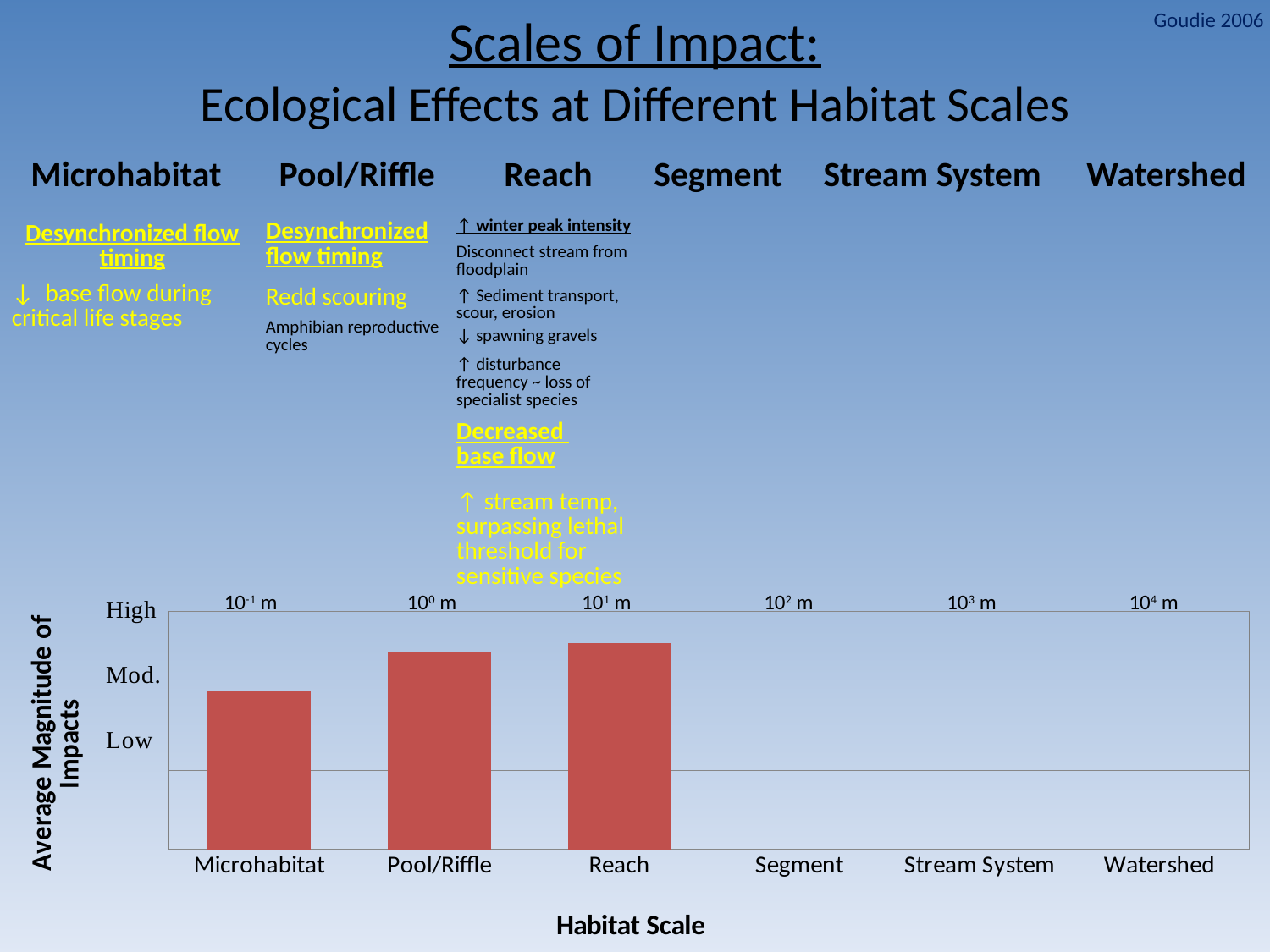
How many categories are listed along the x axis of the chart? 6 How many categories in the chart actually have a bar plotted? 3 What kind of chart is shown on the slide? bar chart Is the bar for Reach above or below the Mod. level on the y axis? above What is the title of the y axis of the chart? Average Magnitude of Impacts Which category has the tallest bar in the chart? Reach Which bar is taller, Pool/Riffle or Reach? Reach Among the categories with a plotted bar, which has the shortest bar? Microhabitat Is the bar for Microhabitat above or below the Low level on the y axis? above Which bar is taller, Microhabitat or Pool/Riffle? Pool/Riffle What is the title of the x axis of the chart? Habitat Scale Do the bar heights rise or fall from Microhabitat to Reach along the x axis? rise